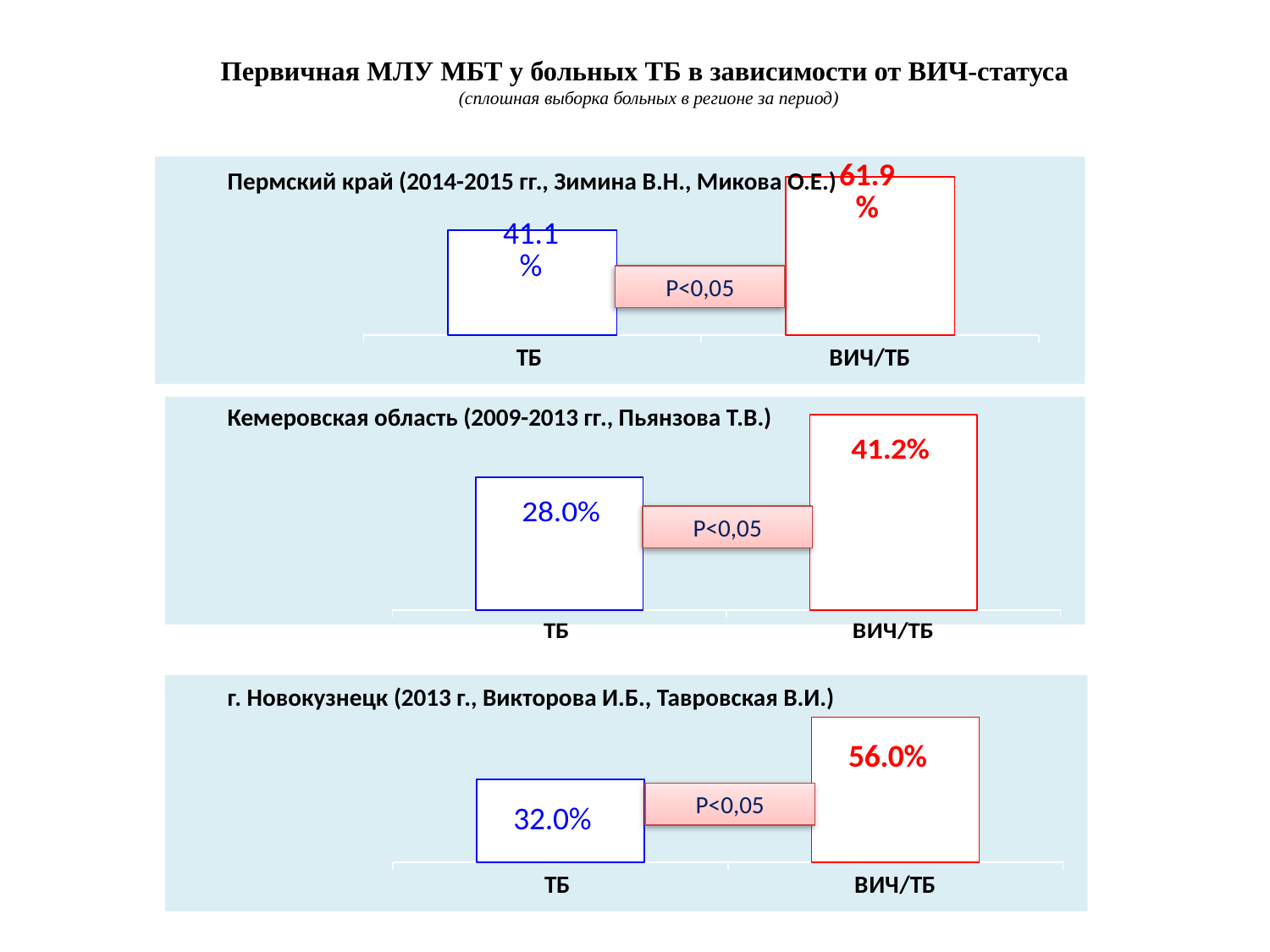
In the Кемеровская область chart, what is the value for ВИЧ/ТБ? 41.2% In the Пермский край chart, what is the value for ВИЧ/ТБ? 61.9% How many categories are shown in the Кемеровская область chart? 2 In the Пермский край chart, what is the difference between the ВИЧ/ТБ and ТБ values? 20.8% In the Пермский край chart, what is the value for ТБ? 41.1% In the г. Новокузнецк chart, what is the value for ТБ? 32.0% In the Кемеровская область chart, which category has the lower value? ТБ In the Кемеровская область chart, what is the value for ТБ? 28.0% In the г. Новокузнецк chart, what is the difference between the ВИЧ/ТБ and ТБ values? 24.0% In the Пермский край chart, which category has the higher value? ВИЧ/ТБ What kind of chart is the г. Новокузнецк chart? bar chart In the г. Новокузнецк chart, what is the value for ВИЧ/ТБ? 56.0%